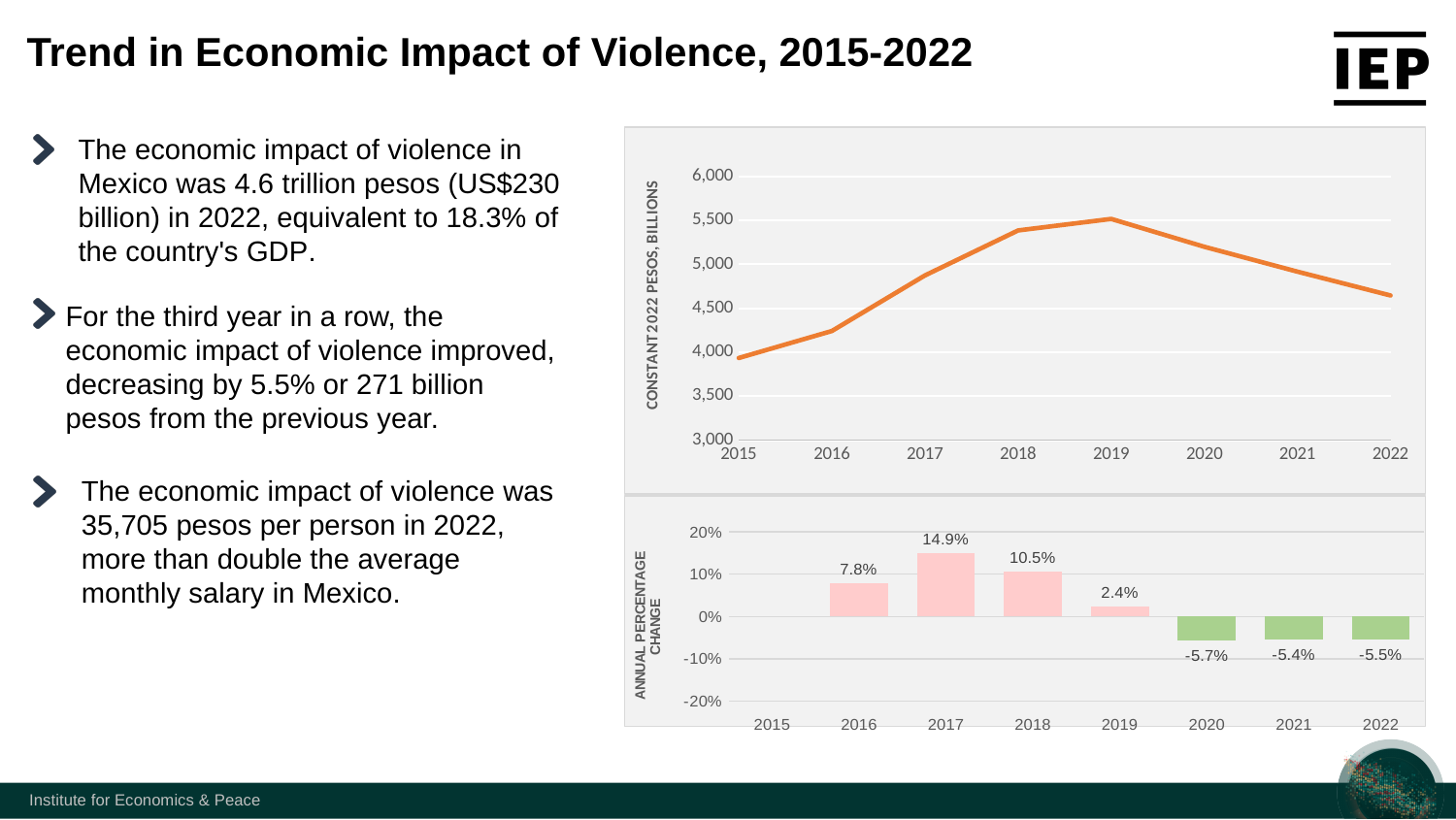
In the bottom chart (annual percentage change), which is larger, the value for 2016 or the value for 2018? 2018 In the bottom chart (annual percentage change), what is the value for 2020? -5.7% In the bottom chart (annual percentage change), how many years have a bar plotted? 7 In the bottom chart (annual percentage change), which year has the lowest value? 2020 In the bottom chart (annual percentage change), what is the difference between the values for 2017 and 2018? 4.4 percentage points In the top chart (constant 2022 pesos, billions), is the value for 2015 greater or less than 4,000? less In the bottom chart (annual percentage change), which year has the highest value? 2017 In the top chart (constant 2022 pesos, billions), which year has the highest value? 2019 In the bottom chart (annual percentage change), what is the value for 2017? 14.9% In the bottom chart (annual percentage change), what is the value for 2022? -5.5% What kind of chart is the top chart on the slide? line chart In the top chart (constant 2022 pesos, billions), is the value for 2019 greater or less than 5,000? greater